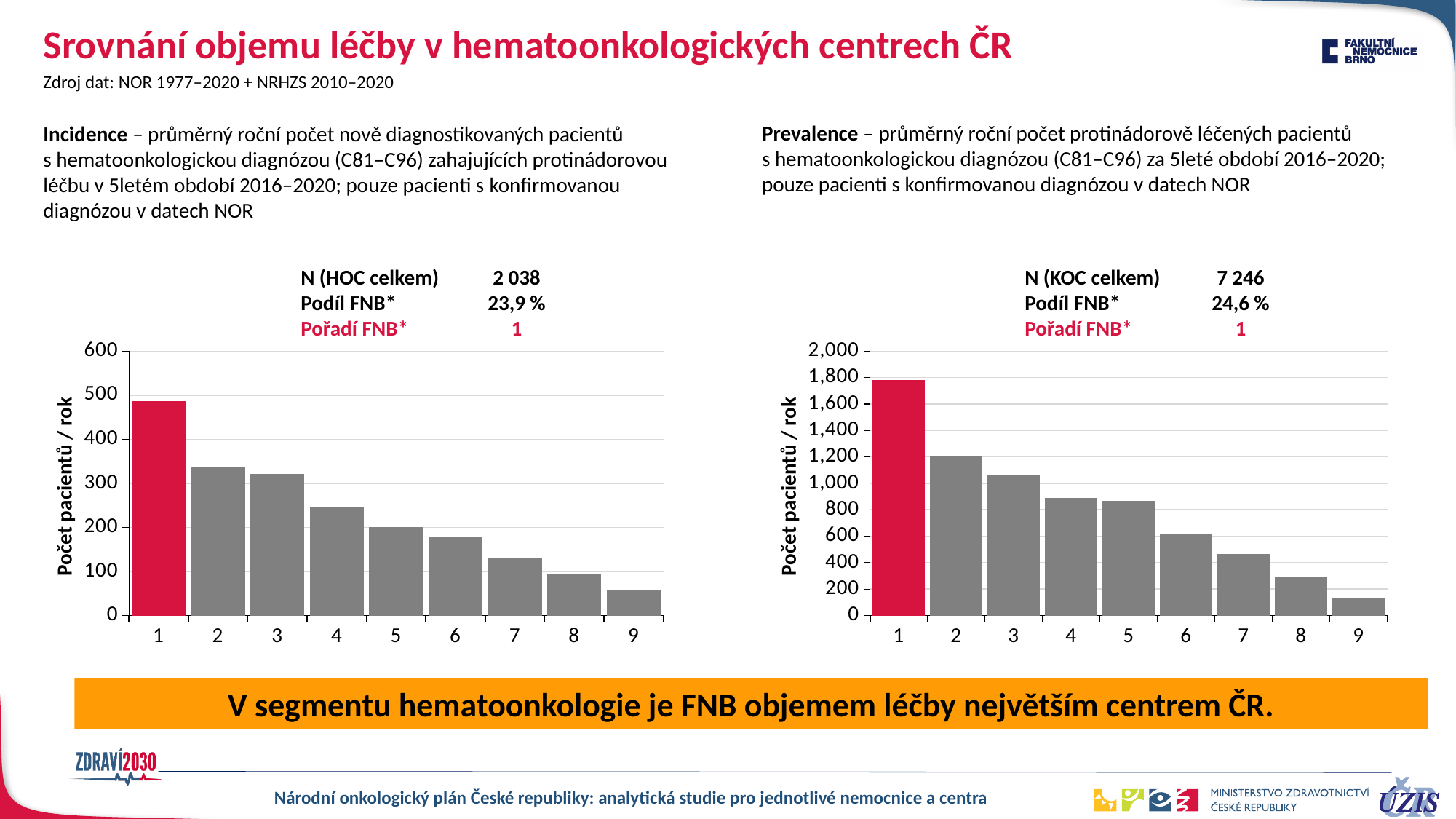
In the right chart (Prevalence), is the value for category 9 greater or less than 200? less What is the y-axis label of the left chart (Incidence)? Počet pacientů / rok In the left chart (Incidence), do the values rise or fall from category 1 to category 9? fall What kind of chart is the right chart (Prevalence)? bar chart In the left chart (Incidence), which category has the highest value? 1 In the right chart (Prevalence), which category has the lowest value? 9 In the right chart (Prevalence), is the value for category 1 greater or less than 1,600? greater In the left chart (Incidence), is the value for category 1 greater or less than 400? greater In the right chart (Prevalence), which is larger, the value for category 2 or the value for category 6? 2 How many categories are shown on the x axis of the left chart (Incidence)? 9